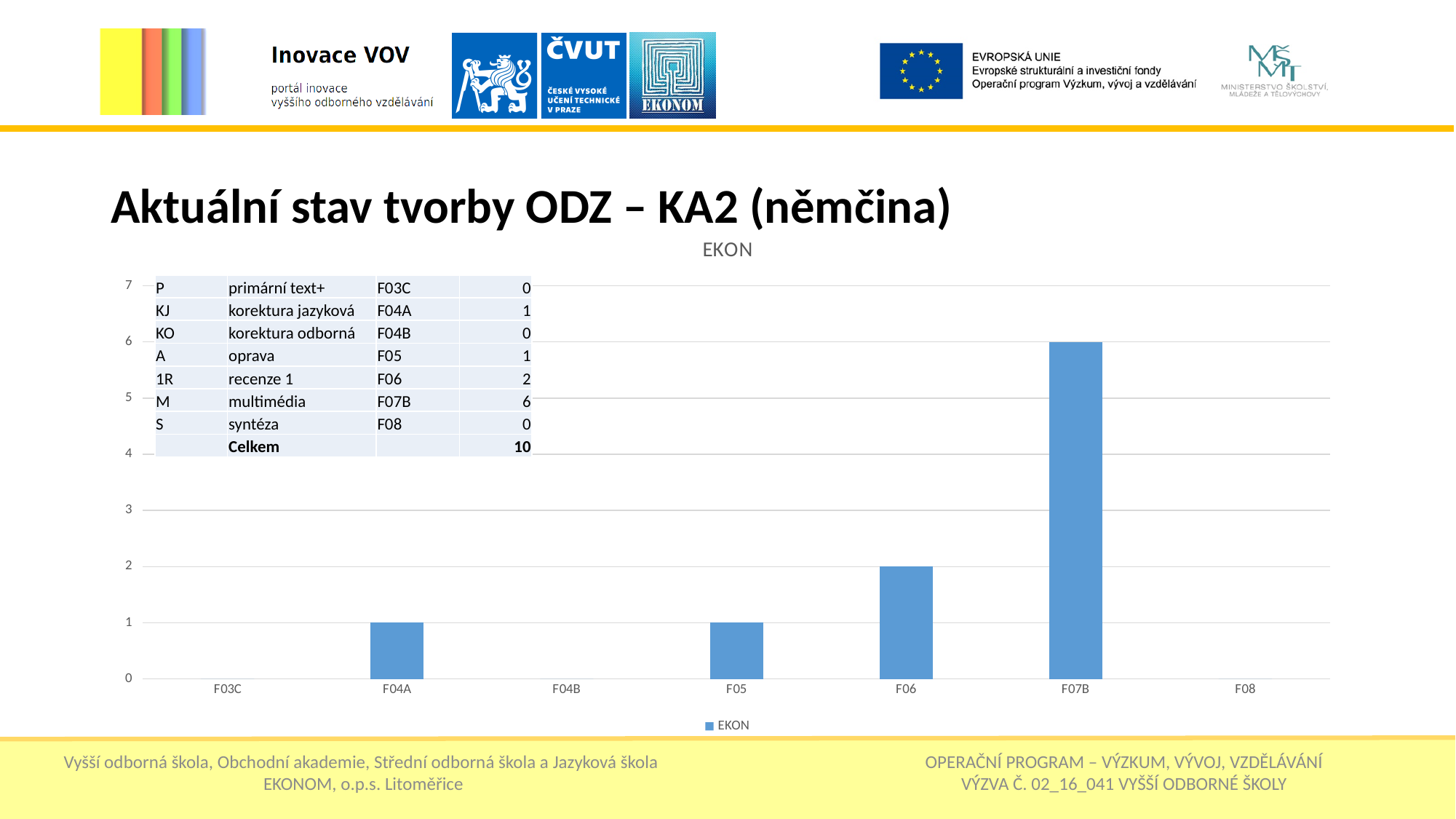
What is the value for F04A? 1 What is the total (Celkem) shown in the table on the chart? 10 What is the value for F07B? 6 Is the value for F07B greater or less than 5? greater What is the value for F06? 2 What type of chart is shown on the slide? bar chart What is the title of the chart? EKON How many categories are shown on the x axis of the chart? 7 How many series does the chart legend list? 1 What is the difference between the values for F07B and F06? 4 Which category has the highest value? F07B Which is larger, the value for F06 or the value for F05? F06